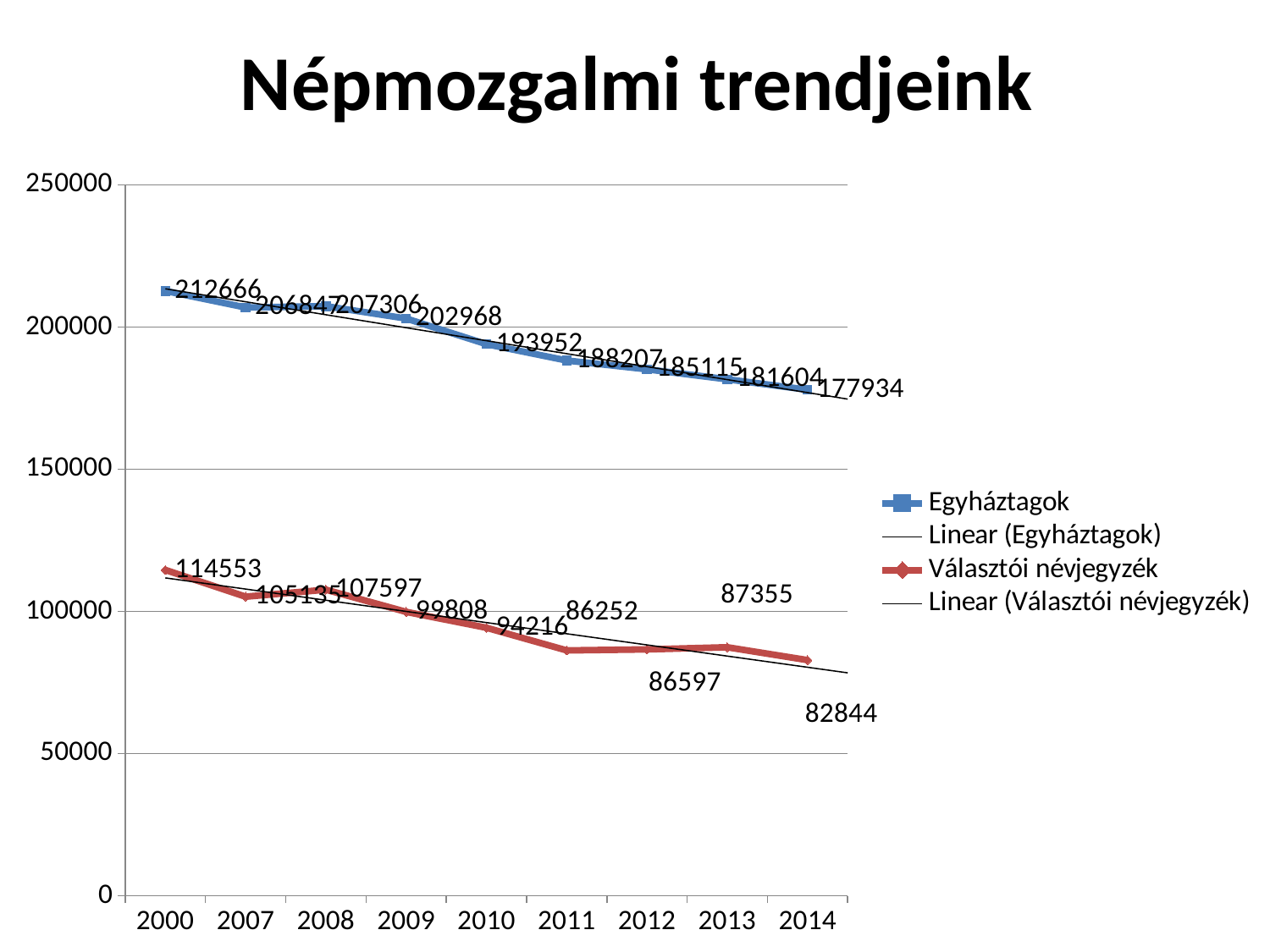
In which year is the Választói névjegyzék value highest? 2000 How many years are shown on the x axis? 9 What type of chart is shown on the slide? line chart What is the value for Választói névjegyzék in 2014? 82844 Does the Egyháztagok series generally rise or fall from 2000 to 2014? fall In which year is the Egyháztagok value lowest? 2014 What is the value for Egyháztagok in 2010? 193952 What is the value for Egyháztagok in 2000? 212666 What is the title of the chart? Népmozgalmi trendjeink What is the difference between the Egyháztagok values in 2000 and 2014? 34732 How many entries does the legend list? 4 Which is larger, the Választói névjegyzék value in 2013 or in 2012? 2013